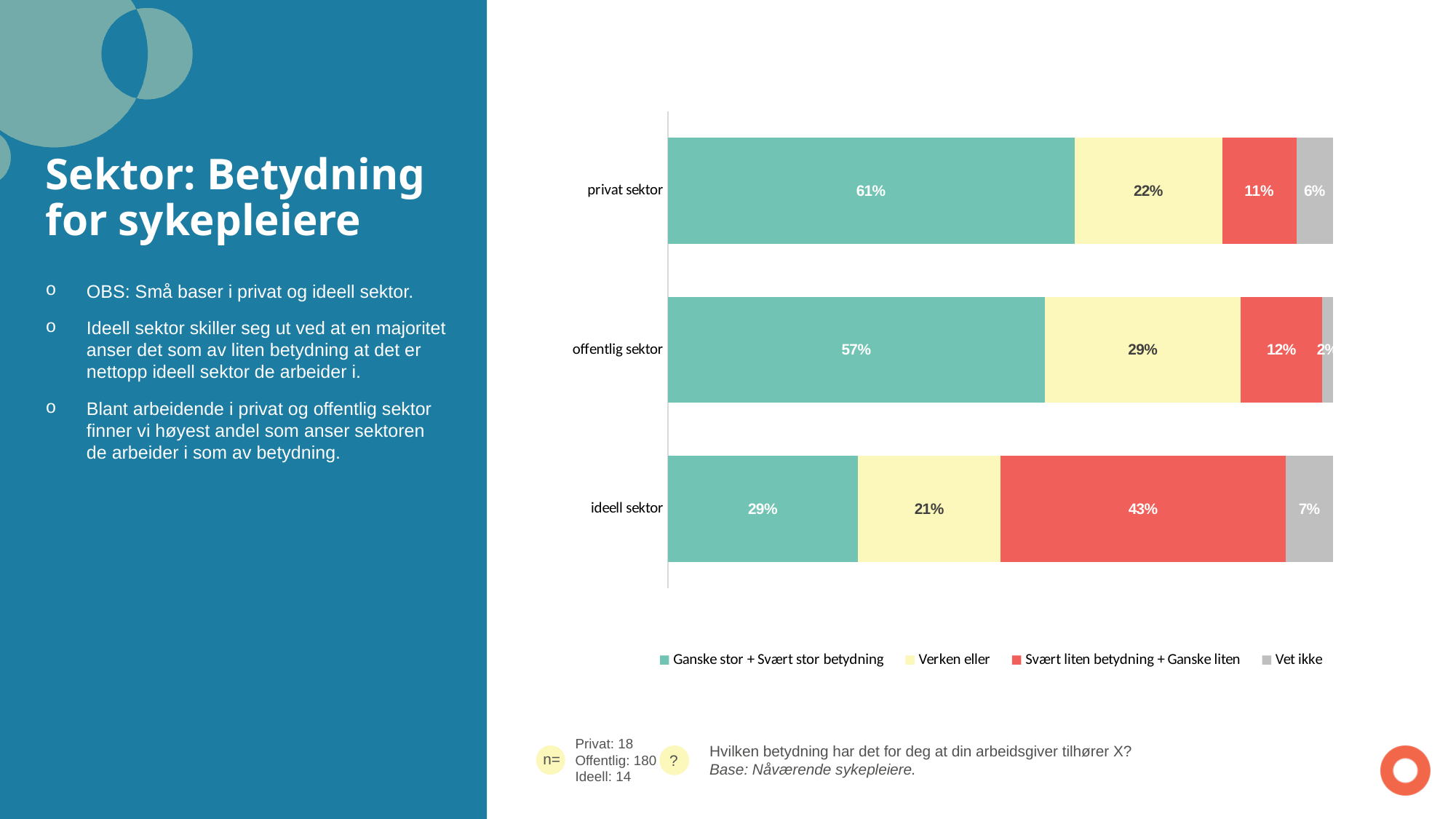
Which sector has the highest "Ganske stor + Svært stor betydning" share? privat sektor What is the difference between the "Svært liten betydning + Ganske liten" values for ideell sektor and offentlig sektor? 31% How many series does the legend list? 4 What kind of chart is shown on the slide? stacked bar chart What is the "Verken eller" value for offentlig sektor? 29% How many sectors are shown on the chart? 3 Which legend entry is shown in red? Svært liten betydning + Ganske liten What is the "Vet ikke" value for privat sektor? 6% Which is larger: the "Ganske stor + Svært stor betydning" value for offentlig sektor or for ideell sektor? offentlig sektor What is the "Svært liten betydning + Ganske liten" value for ideell sektor? 43% Which sector has the lowest "Verken eller" share? ideell sektor What percentage of privat sektor respondents answered "Ganske stor + Svært stor betydning"? 61%